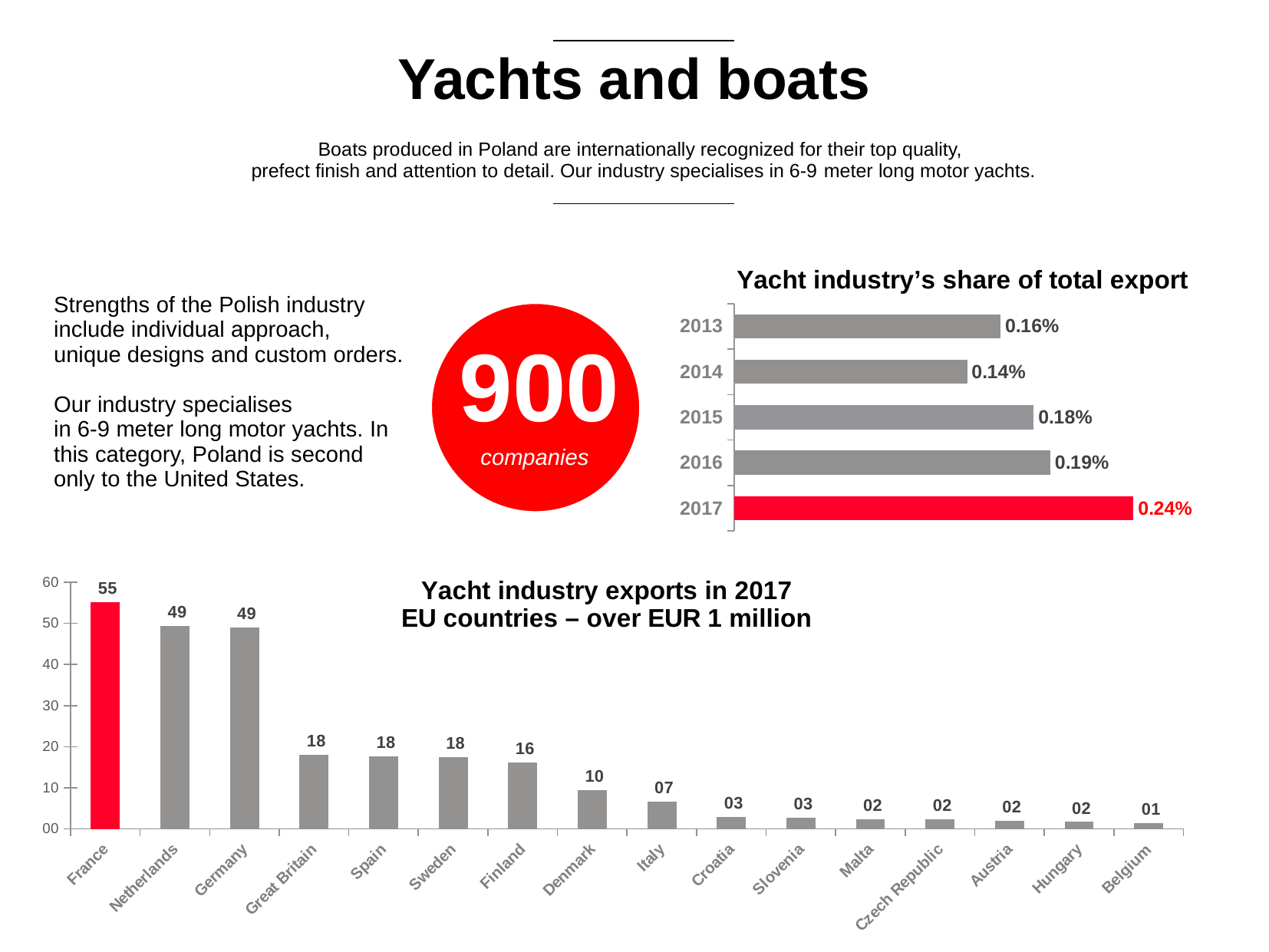
In the 'Yacht industry's share of total export' chart, which year has the lowest share? 2014 In the 'Yacht industry's share of total export' chart, how many years are shown? 5 In the 'Yacht industry exports in 2017' chart, what is the difference between France and Netherlands? 6 In the 'Yacht industry exports in 2017' chart, what is the value for France? 55 In the 'Yacht industry exports in 2017' chart, how many countries are shown? 16 In the 'Yacht industry's share of total export' chart, what is the value for 2017? 0.24% In the 'Yacht industry exports in 2017' chart, which country has the highest value? France In the 'Yacht industry's share of total export' chart, is the value for 2015 larger or smaller than the value for 2016? smaller In the 'Yacht industry's share of total export' chart, what is the difference between the 2017 and 2013 values? 0.08% What kind of chart is the 'Yacht industry exports in 2017' chart? bar chart In the 'Yacht industry exports in 2017' chart, what is the value for Denmark? 10 In the 'Yacht industry exports in 2017' chart, which country has the lowest value? Belgium